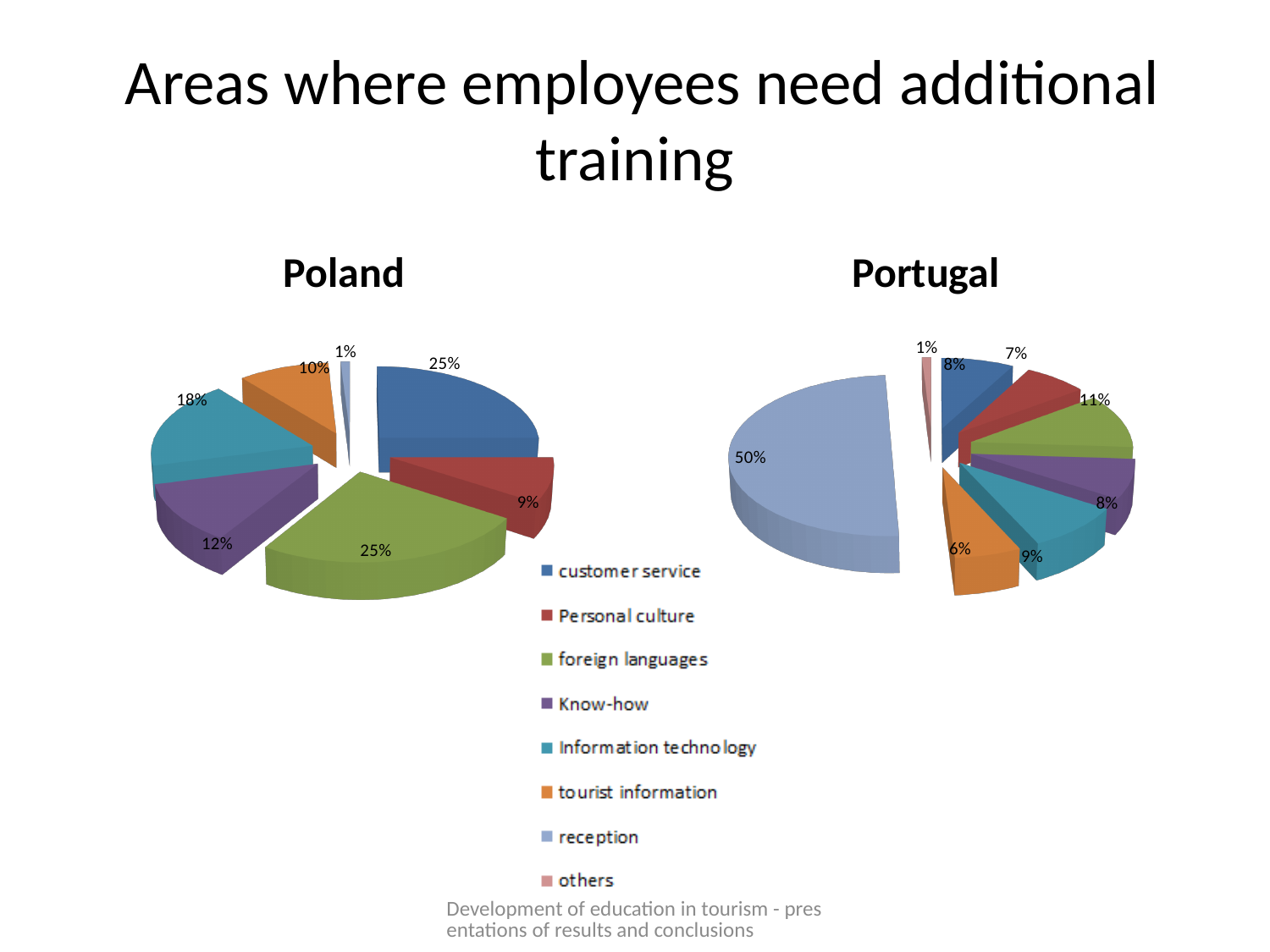
In the Portugal chart, what percentage is shown for reception? 50% What type of chart is used for Poland and Portugal? pie chart In the Portugal chart, what percentage is shown for foreign languages? 11% In the Poland chart, what share is labelled for the foreign languages slice? 25% In the Poland chart, what percentage is shown for Information technology? 18% In the Poland chart, what is the difference between the Information technology share and the Know-how share? 6% In the Portugal chart, which is larger, the Information technology slice or the tourist information slice? Information technology How many categories does the legend list? 8 In the Portugal chart, which category has the smallest slice? others What is the title of the slide? Areas where employees need additional training In the Portugal chart, which category has the largest slice? reception In the Poland chart, which category has the smallest slice? reception